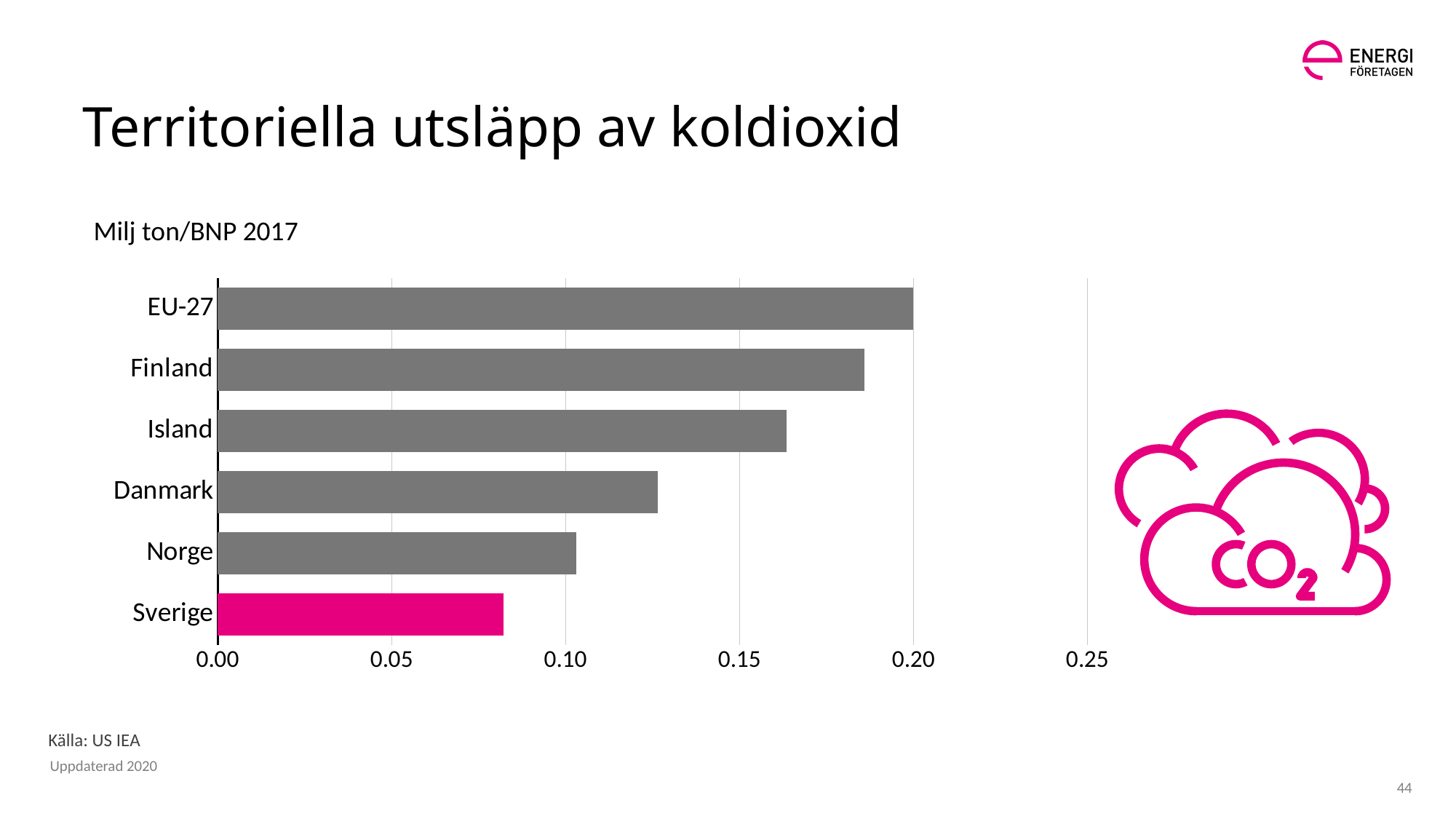
How many countries or regions are shown in the chart? 6 Is the value for Finland greater or less than 0.20? less Which category has the lowest value in the chart? Sverige Is the value for Sverige greater or less than 0.05? greater Is the value for Sverige greater or less than 0.10? less Which bar is highlighted in a different colour (pink) from the others? Sverige Which category has the highest value in the chart? EU-27 What unit label is shown above the chart? Milj ton/BNP 2017 Which has a larger value, Finland or Danmark? Finland What kind of chart is shown on the slide? bar chart